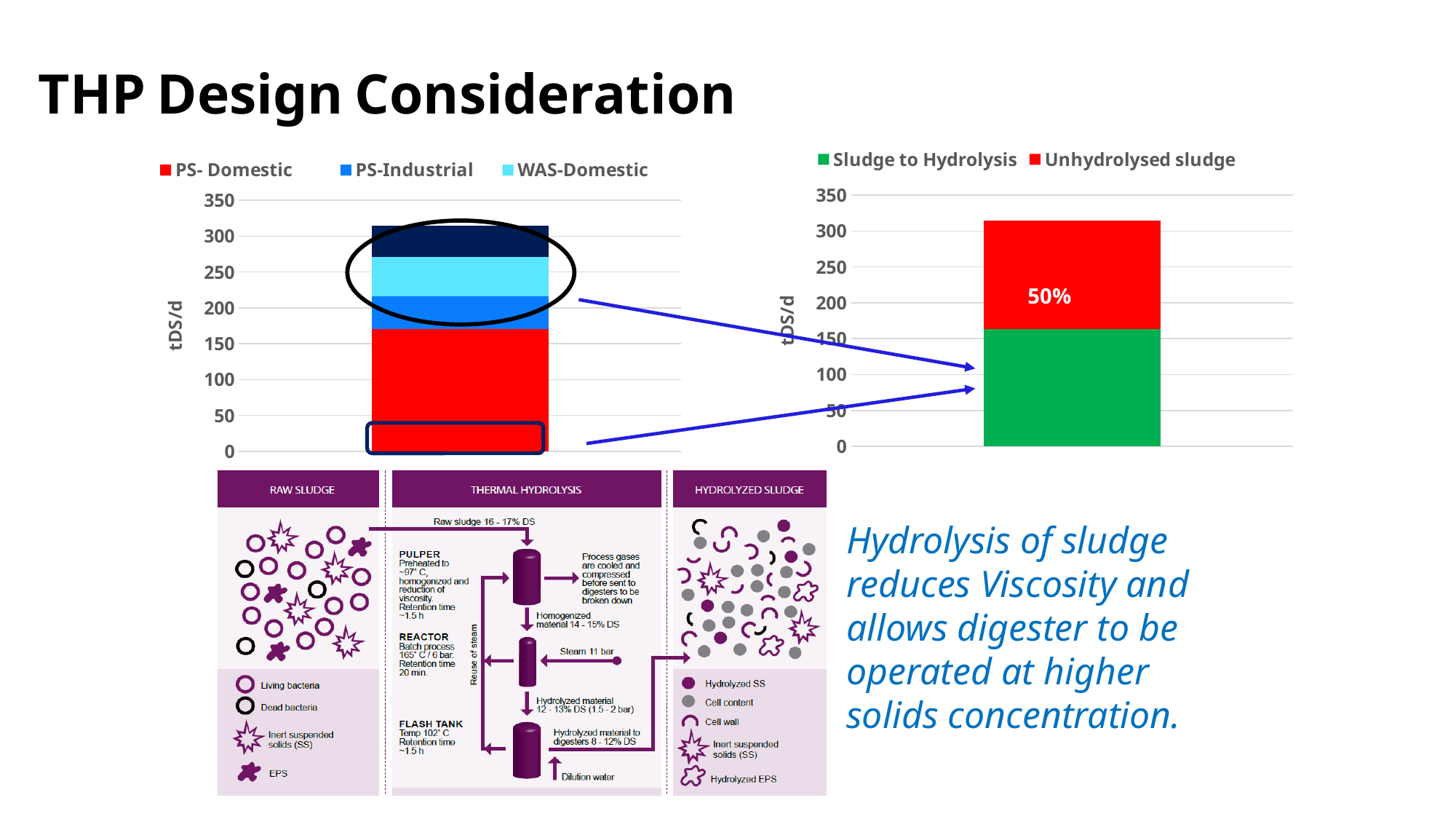
What kind of chart is the left chart on the slide? bar chart In the left chart, which legend series has the largest segment in the stacked bar? PS- Domestic In the left chart, is the value for PS- Domestic greater or less than 150? greater What is the y-axis label of the left chart? tDS/d In the right chart, is the value for Sludge to Hydrolysis greater or less than 150? greater How many series does the legend of the left chart list? 3 In the left chart, which is larger, the PS- Domestic segment or the PS-Industrial segment? PS- Domestic In the right chart, is the total height of the stacked bar greater or less than 300? greater In the right chart, which colour represents Sludge to Hydrolysis? green How many series does the legend of the right chart list? 2 In the right chart, what data label is printed on the Unhydrolysed sludge segment? 50%